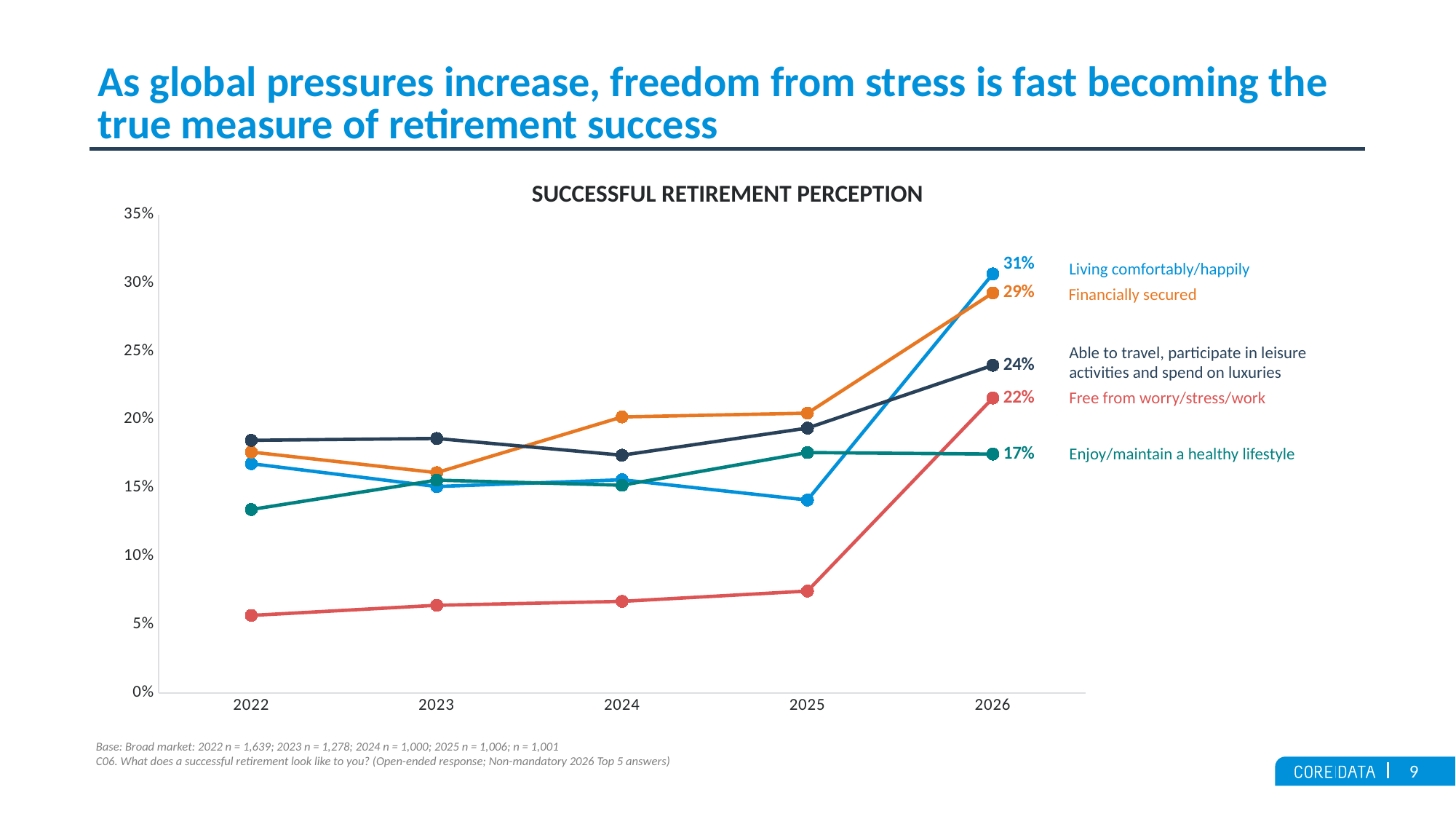
What kind of chart is shown on the slide? Line chart What is the value for Living comfortably/happily in 2026? 31% What is the value for Enjoy/maintain a healthy lifestyle in 2026? 17% In 2026, which is larger: Financially secured or Able to travel, participate in leisure activities and spend on luxuries? Financially secured What is the difference between Living comfortably/happily and Enjoy/maintain a healthy lifestyle in 2026? 14 percentage points Which series has the highest value in 2026? Living comfortably/happily Does the Free from worry/stress/work series rise or fall from 2022 to 2026? Rise How many years are shown on the x axis? 5 Is the value for Free from worry/stress/work in 2022 greater or less than 10%? less Which series has the lowest value in 2026? Enjoy/maintain a healthy lifestyle What is the value for Free from worry/stress/work in 2026? 22% What is the value for Financially secured in 2026? 29%